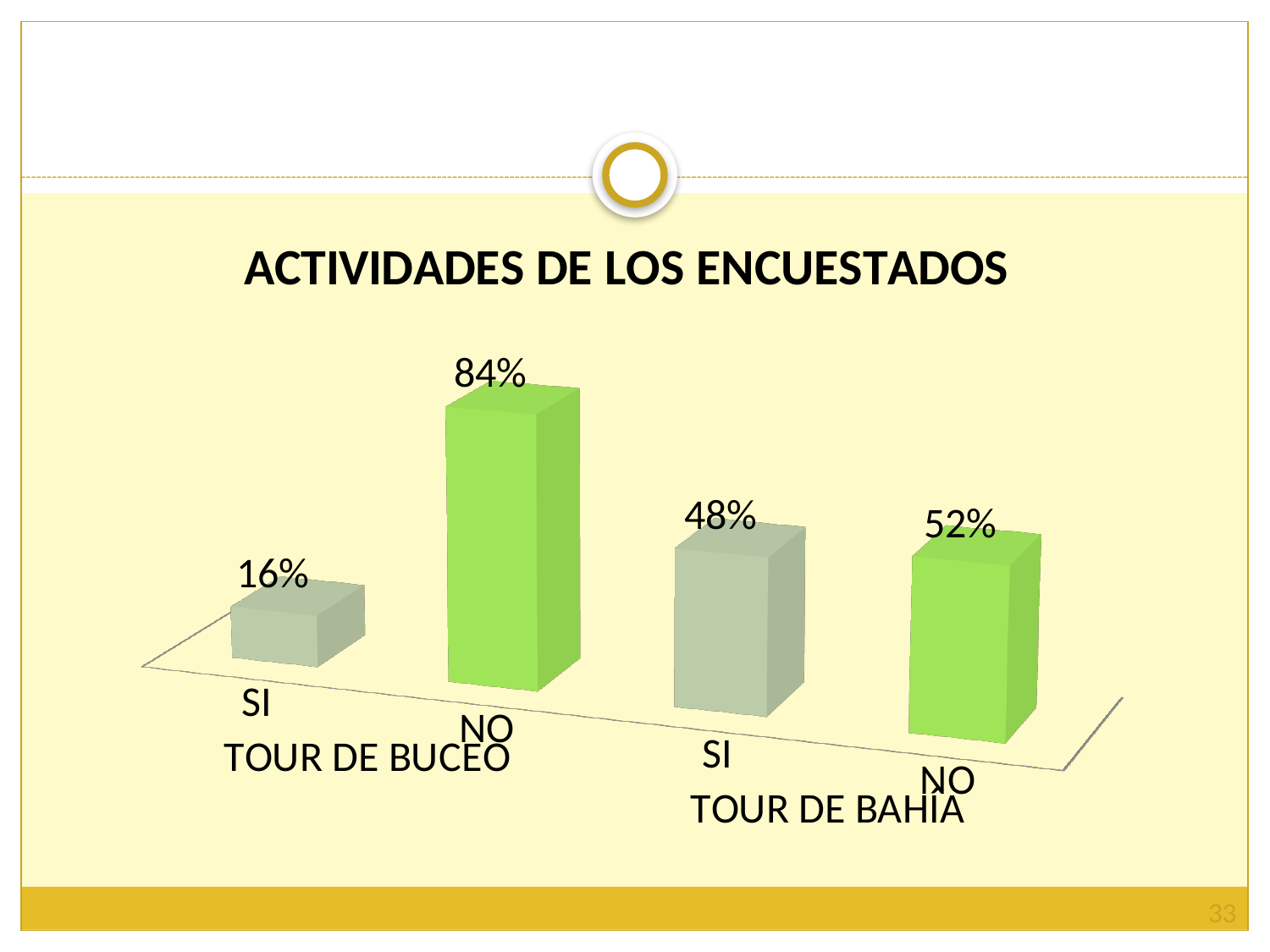
How many bars are shown in the chart? 4 What is the value for NO under TOUR DE BAHIA? 52% Which bar has the highest value? NO (TOUR DE BUCEO) What kind of chart is shown on the slide? Bar chart Which bar has the lowest value? SI (TOUR DE BUCEO) What is the value for NO under TOUR DE BUCEO? 84% Which is larger: SI for TOUR DE BAHIA or SI for TOUR DE BUCEO? SI for TOUR DE BAHIA What is the title of the chart? ACTIVIDADES DE LOS ENCUESTADOS What is the difference between NO and SI for TOUR DE BAHIA? 4% What is the difference between NO and SI for TOUR DE BUCEO? 68% What is the value for SI under TOUR DE BUCEO? 16% What is the value for SI under TOUR DE BAHIA? 48%